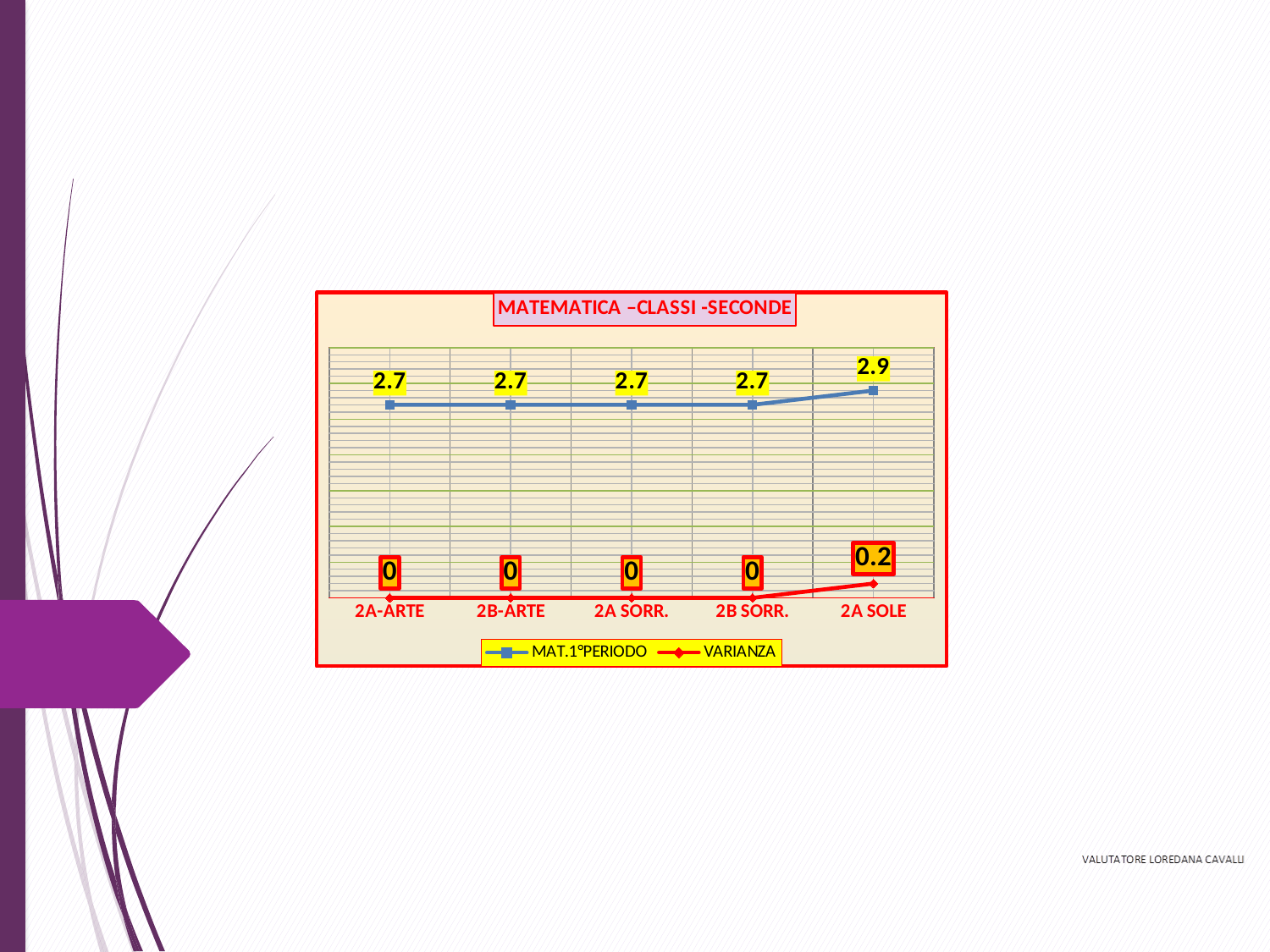
What kind of chart is shown? line chart How many categories are shown on the x axis? 5 What is the MAT.1°PERIODO value for 2A SOLE? 2.9 What is the VARIANZA value for 2A-ARTE? 0 What is the VARIANZA value for 2A SOLE? 0.2 How many series does the legend list? 2 Is the MAT.1°PERIODO value for 2A SOLE larger or smaller than the value for 2B SORR.? larger What is the MAT.1°PERIODO value for 2B SORR.? 2.7 Which category has the highest VARIANZA value? 2A SOLE Which category has the highest MAT.1°PERIODO value? 2A SOLE What is the difference between the MAT.1°PERIODO values for 2A SOLE and 2A-ARTE? 0.2 What is the title of the chart? MATEMATICA –CLASSI -SECONDE